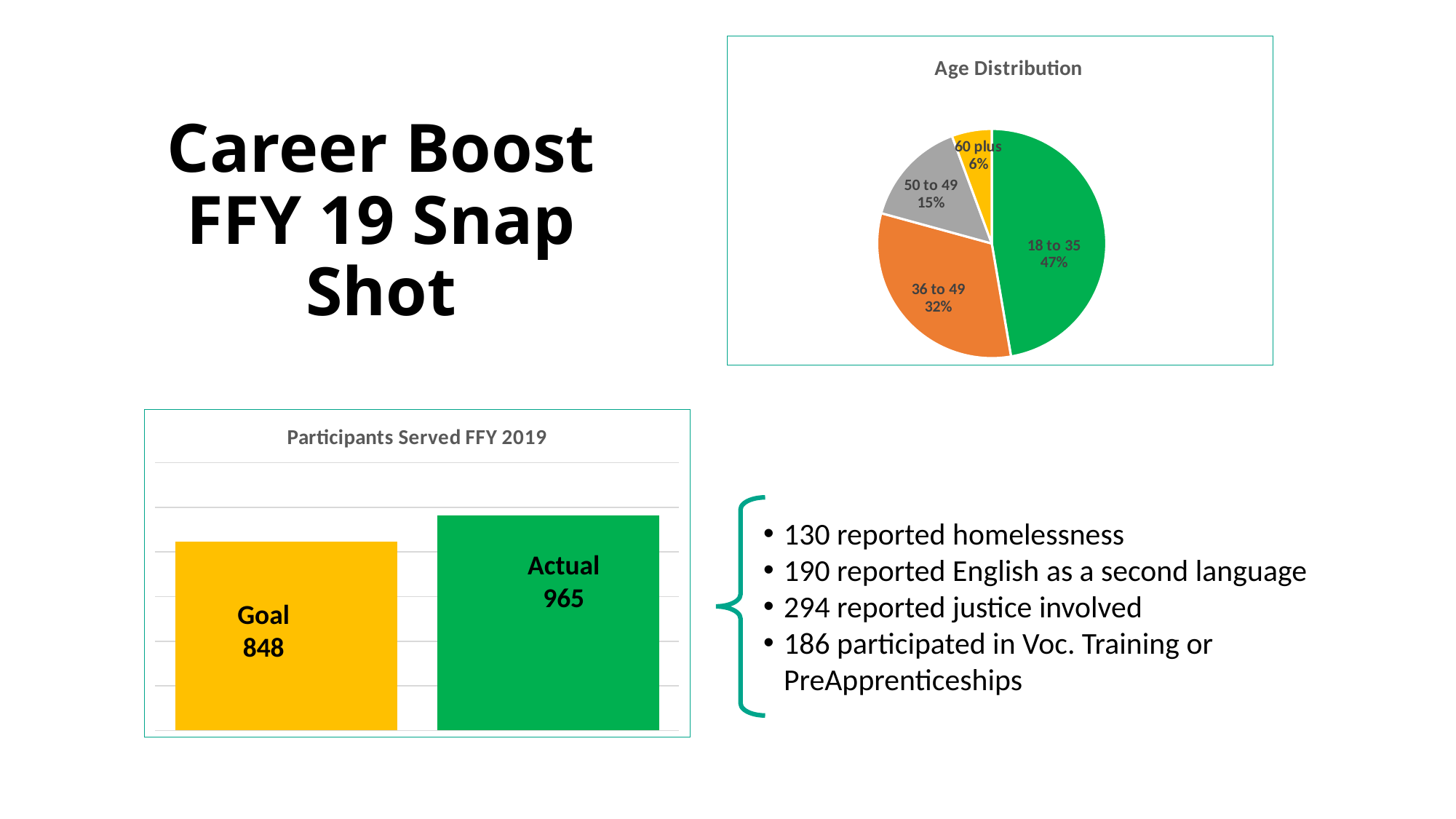
In the Participants Served FFY 2019 chart, what is the Goal value? 848 What kind of chart is the Participants Served FFY 2019 chart? Bar chart In the Age Distribution chart, what share of participants are aged 18 to 35? 47% In the Age Distribution chart, which age group has the smallest share? 60 plus In the Age Distribution chart, how many slices does the pie have? 4 In the Participants Served FFY 2019 chart, what is the Actual value? 965 In the Age Distribution chart, what percentage is shown for the 60 plus slice? 6% What kind of chart is the Age Distribution chart? Pie chart In the Participants Served FFY 2019 chart, by how much does Actual exceed Goal? 117 In the Age Distribution chart, what percentage is shown for the 36 to 49 slice? 32% In the Age Distribution chart, which age group has the largest share? 18 to 35 In the Participants Served FFY 2019 chart, which is larger, Goal or Actual? Actual